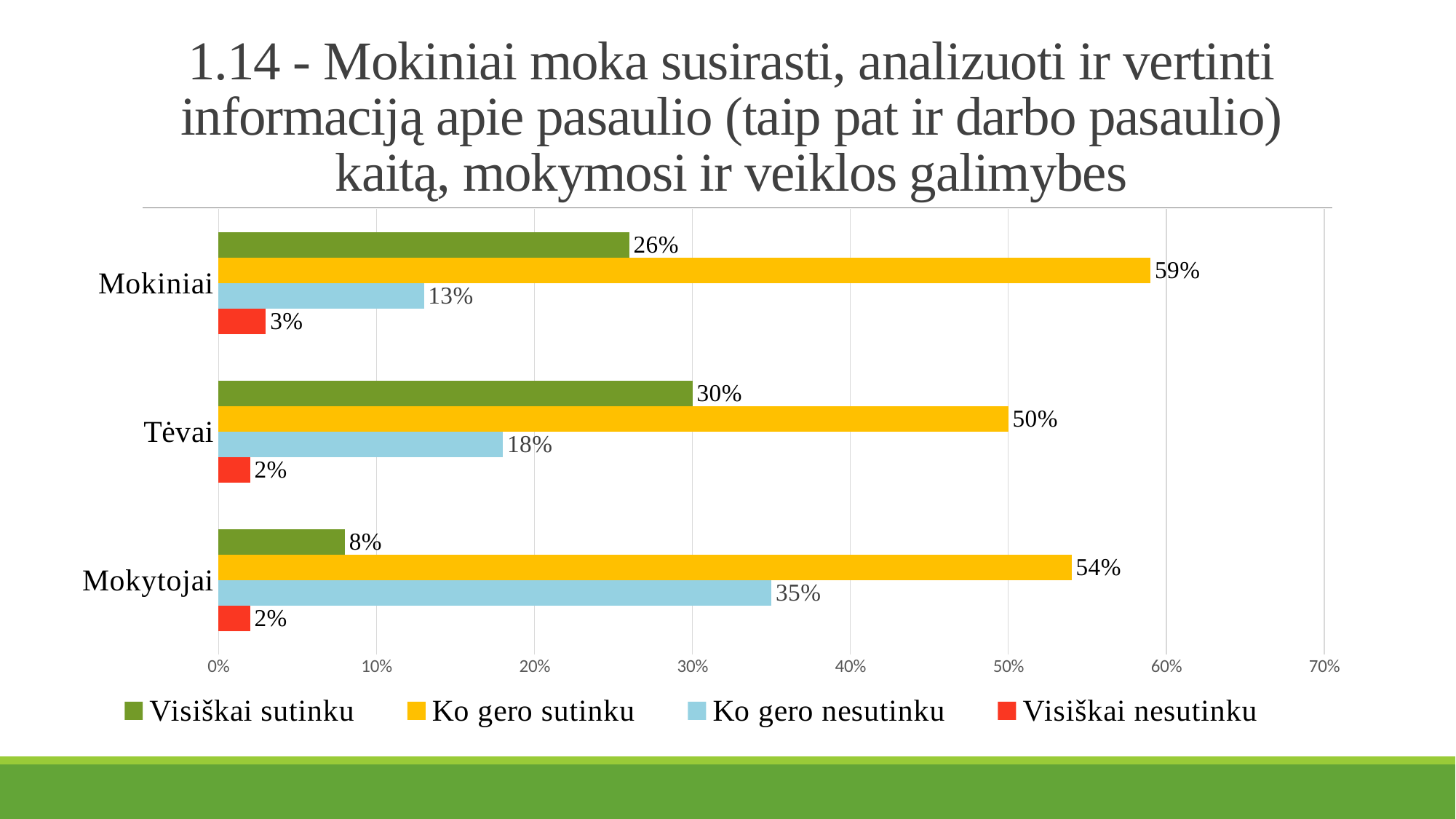
How many categories are shown on the y axis? 3 What is the value for "Ko gero sutinku" for Mokiniai? 59% What is the value for "Visiškai sutinku" for Mokytojai? 8% What is the difference between the "Ko gero sutinku" values for Mokiniai and Tėvai? 9% How many series does the legend list? 4 Which category has the lowest value for "Visiškai sutinku"? Mokytojai Which category has the highest value for "Ko gero nesutinku"? Mokytojai Which is larger: the "Visiškai sutinku" value for Mokiniai or for Tėvai? Tėvai What kind of chart is shown on the slide? bar chart What is the value for "Ko gero nesutinku" for Tėvai? 18% Is the value for "Ko gero sutinku" for Mokytojai greater or less than 50%? greater Which colour represents "Visiškai nesutinku" in the legend? red